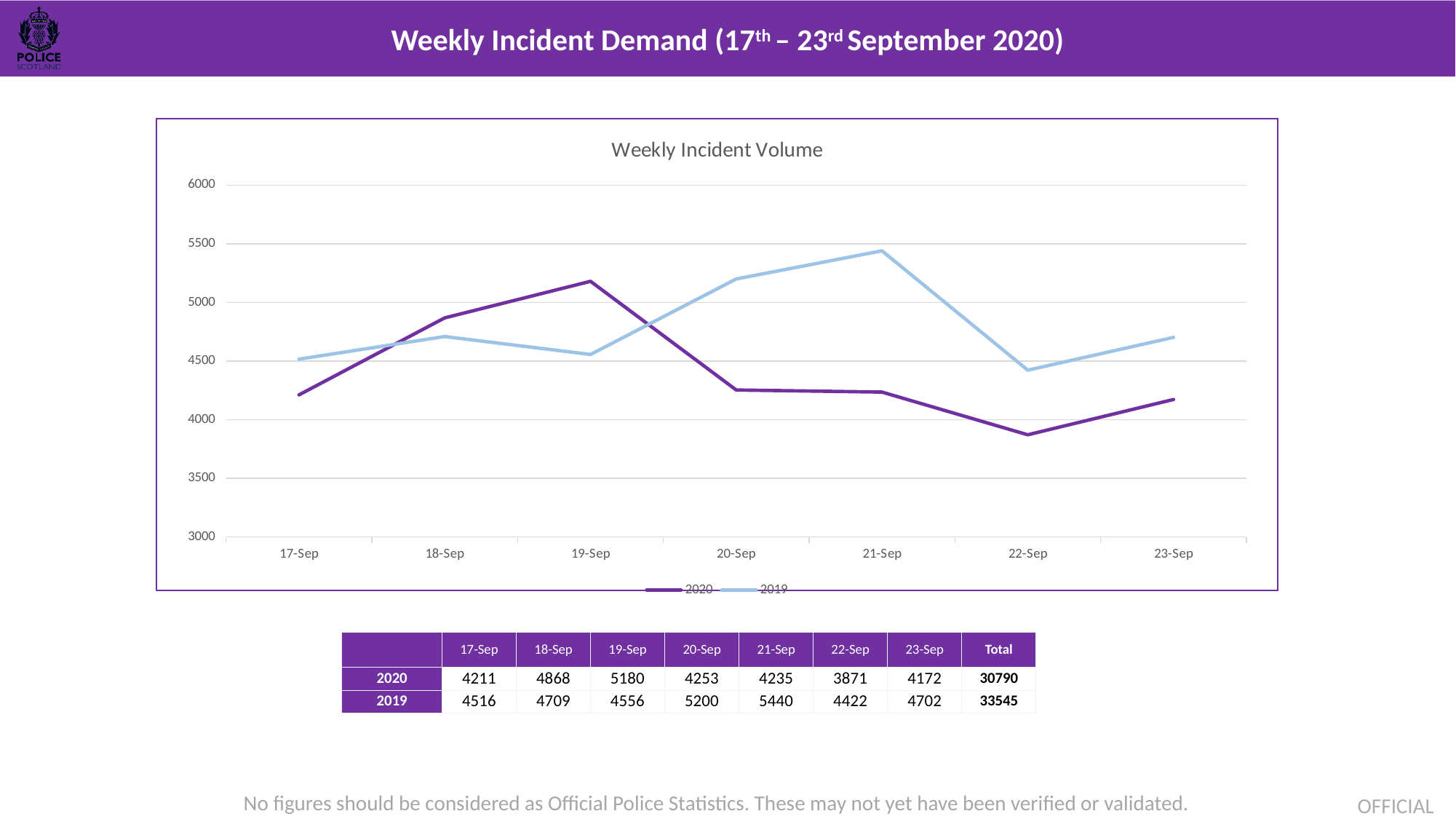
What type of chart is shown on the slide? Line chart On which date is the 2020 incident volume lowest? 22-Sep On which date is the 2020 incident volume highest? 19-Sep What is the title of the chart on the slide? Weekly Incident Volume How many series does the legend of the Weekly Incident Volume chart list? 2 Is the 2020 value on 22-Sep greater or less than 4000? less On which date is the 2019 incident volume highest? 21-Sep What is the difference between the 2019 and 2020 incident volumes on 21-Sep? 1205 How many dates are plotted along the x axis of the Weekly Incident Volume chart? 7 What is the 2020 incident volume on 19-Sep? 5180 What is the 2019 incident volume on 21-Sep? 5440 Which series has the larger value on 19-Sep, 2020 or 2019? 2020